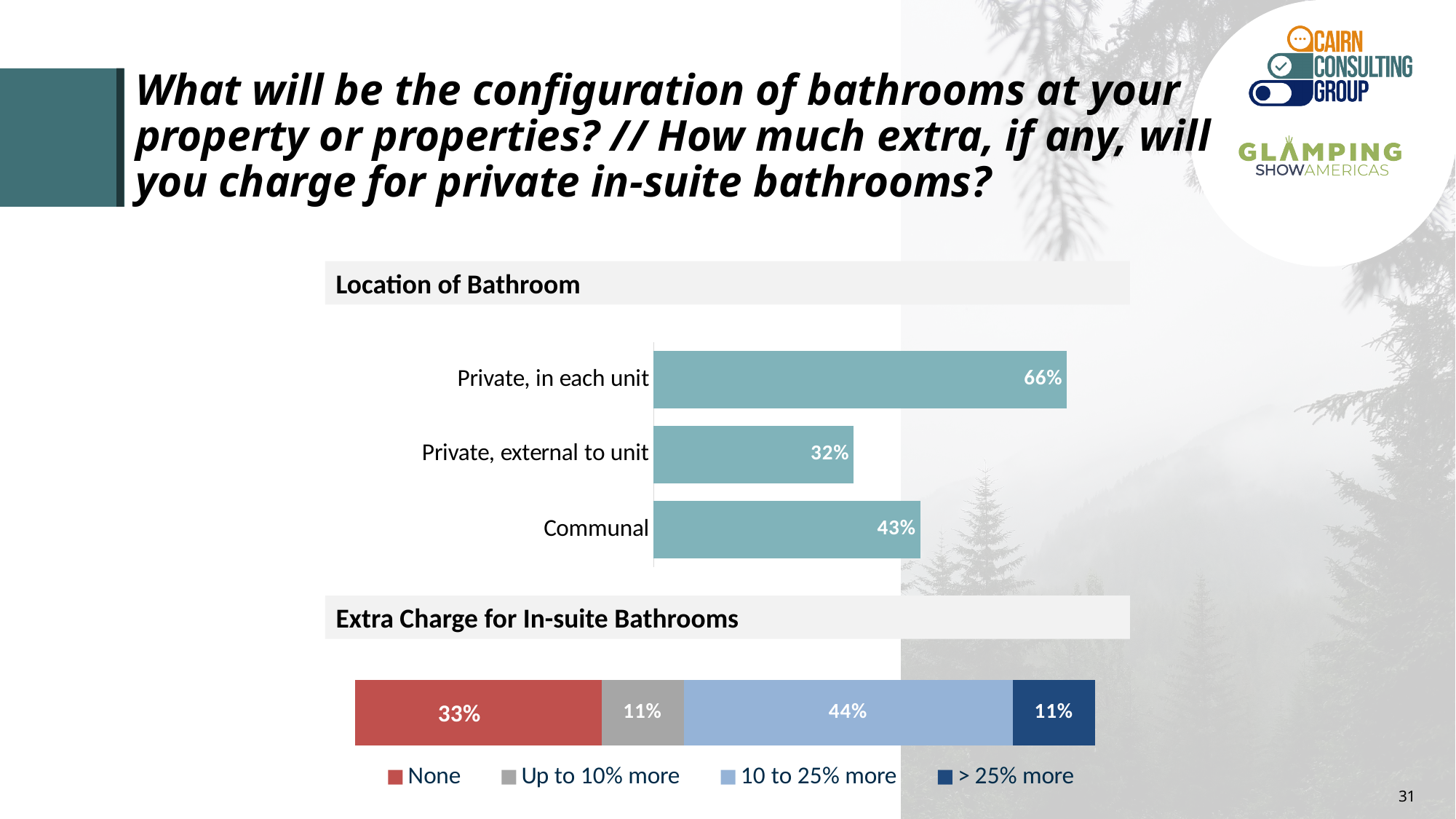
In the 'Location of Bathroom' chart, what is the difference between 'Private, in each unit' and 'Communal'? 23% In the 'Location of Bathroom' chart, what is the value for 'Communal'? 43% In the 'Extra Charge for In-suite Bathrooms' chart, what colour is the 'None' segment? Red In the 'Extra Charge for In-suite Bathrooms' chart, which is larger: 'None' or 'Up to 10% more'? None What kind of chart is the 'Location of Bathroom' chart? Bar chart In the 'Location of Bathroom' chart, which category has the highest value? Private, in each unit In the 'Location of Bathroom' chart, how many categories are shown? 3 In the 'Extra Charge for In-suite Bathrooms' chart, what is the value for '10 to 25% more'? 44% In the 'Location of Bathroom' chart, what is the value for 'Private, in each unit'? 66% In the 'Extra Charge for In-suite Bathrooms' chart, what is the value for 'None'? 33% In the 'Extra Charge for In-suite Bathrooms' chart, how many series does the legend list? 4 In the 'Location of Bathroom' chart, which category has the lowest value? Private, external to unit